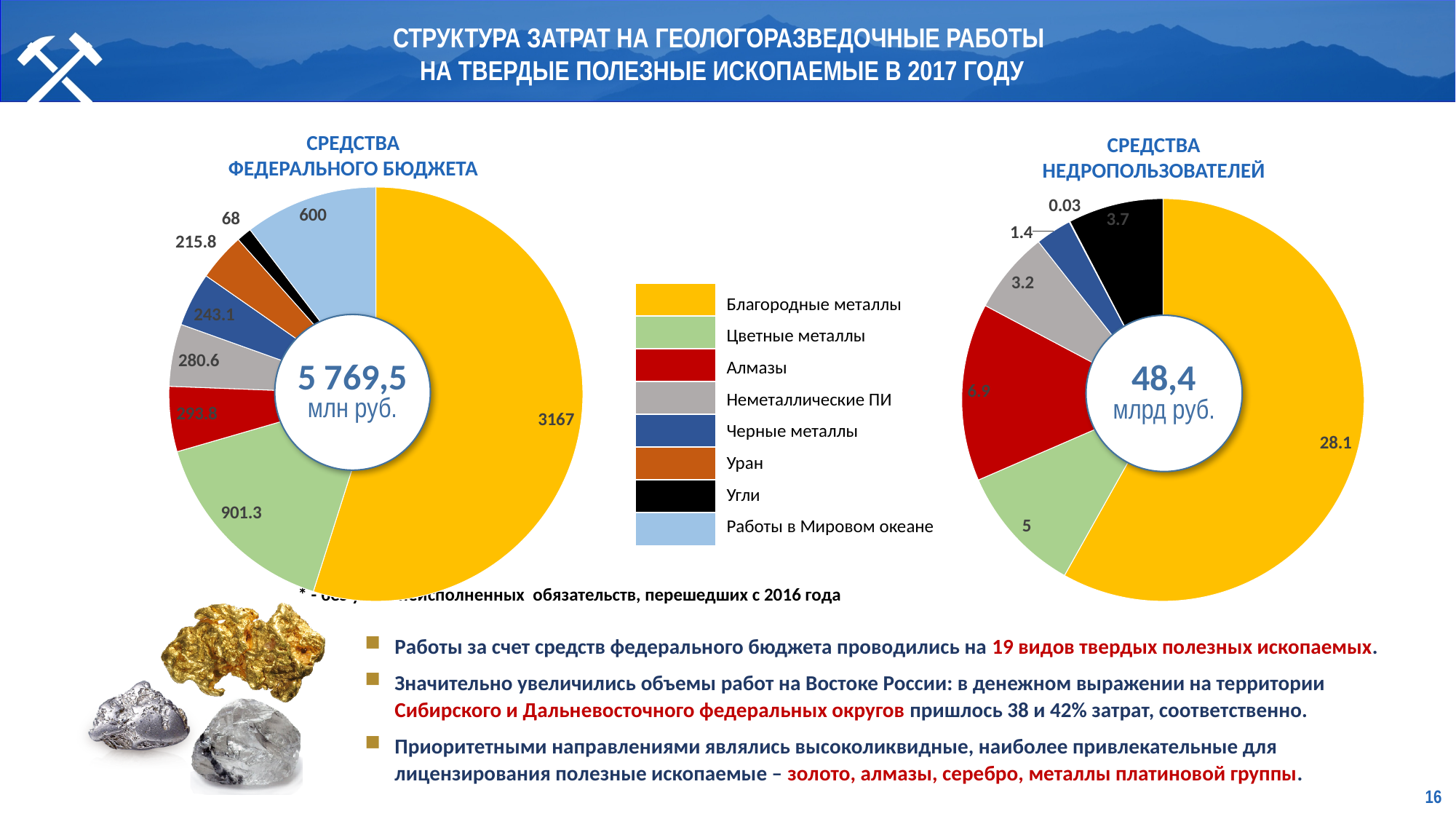
In the chart titled «СРЕДСТВА ФЕДЕРАЛЬНОГО БЮДЖЕТА», what is the difference between the values for Цветные металлы and Работы в Мировом океане? 301.3 In the chart titled «СРЕДСТВА ФЕДЕРАЛЬНОГО БЮДЖЕТА», what is the value for Работы в Мировом океане? 600 In the chart titled «СРЕДСТВА НЕДРОПОЛЬЗОВАТЕЛЕЙ», which category has the largest slice? Благородные металлы In the chart titled «СРЕДСТВА НЕДРОПОЛЬЗОВАТЕЛЕЙ», which is larger: Цветные металлы or Алмазы? Алмазы In the chart titled «СРЕДСТВА НЕДРОПОЛЬЗОВАТЕЛЕЙ», what is the value for Алмазы? 6.9 In the chart titled «СРЕДСТВА ФЕДЕРАЛЬНОГО БЮДЖЕТА», what is the value for Благородные металлы? 3167 In the chart titled «СРЕДСТВА НЕДРОПОЛЬЗОВАТЕЛЕЙ», what is the value for Уран? 0.03 In the chart titled «СРЕДСТВА ФЕДЕРАЛЬНОГО БЮДЖЕТА», what total is shown in the centre of the chart? 5 769,5 млн руб. In the chart titled «СРЕДСТВА ФЕДЕРАЛЬНОГО БЮДЖЕТА», which category has the smallest slice? Угли What kind of chart is the chart titled «СРЕДСТВА НЕДРОПОЛЬЗОВАТЕЛЕЙ»? Pie chart How many entries does the shared legend between the two charts list? 8 In the chart titled «СРЕДСТВА ФЕДЕРАЛЬНОГО БЮДЖЕТА», what is the value for Цветные металлы? 901.3